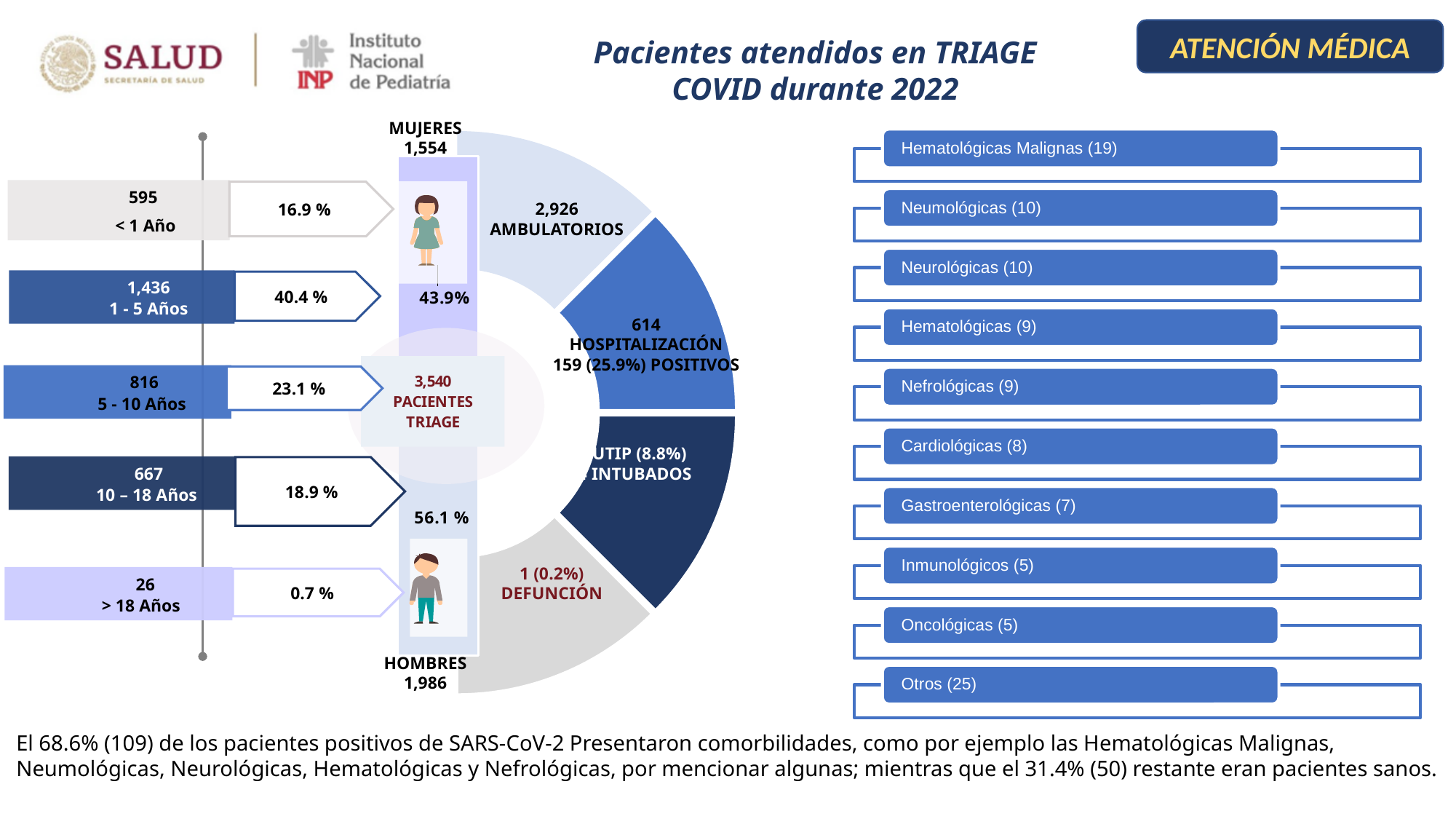
In the age-group chart on the left, how many patients were in the 1 - 5 Años group? 1,436 What kind of chart is the chart in the centre showing Ambulatorios, Hospitalización, UTIP and Defunción? Donut chart In the age-group chart on the left, which age group has the lowest number of patients? > 18 Años In the donut chart in the centre, what is the total number of Pacientes Triage shown at the centre? 3,540 In the age-group chart on the left, what is the difference in patients between the 5 - 10 Años group and the 10 – 18 Años group? 149 In the age-group chart on the left, how many age groups are shown? 5 In the donut chart in the centre, what percentage of patients were Defunción? 0.2% In the age-group chart on the left, what percentage is shown for the < 1 Año group? 16.9 % In the gender figure in the centre, which group is larger, Mujeres or Hombres? Hombres In the donut chart in the centre, how many patients were Ambulatorios? 2,926 In the comorbidities list on the right, how many patients had Hematológicas Malignas? 19 In the age-group chart on the left, which age group has the highest number of patients? 1 - 5 Años